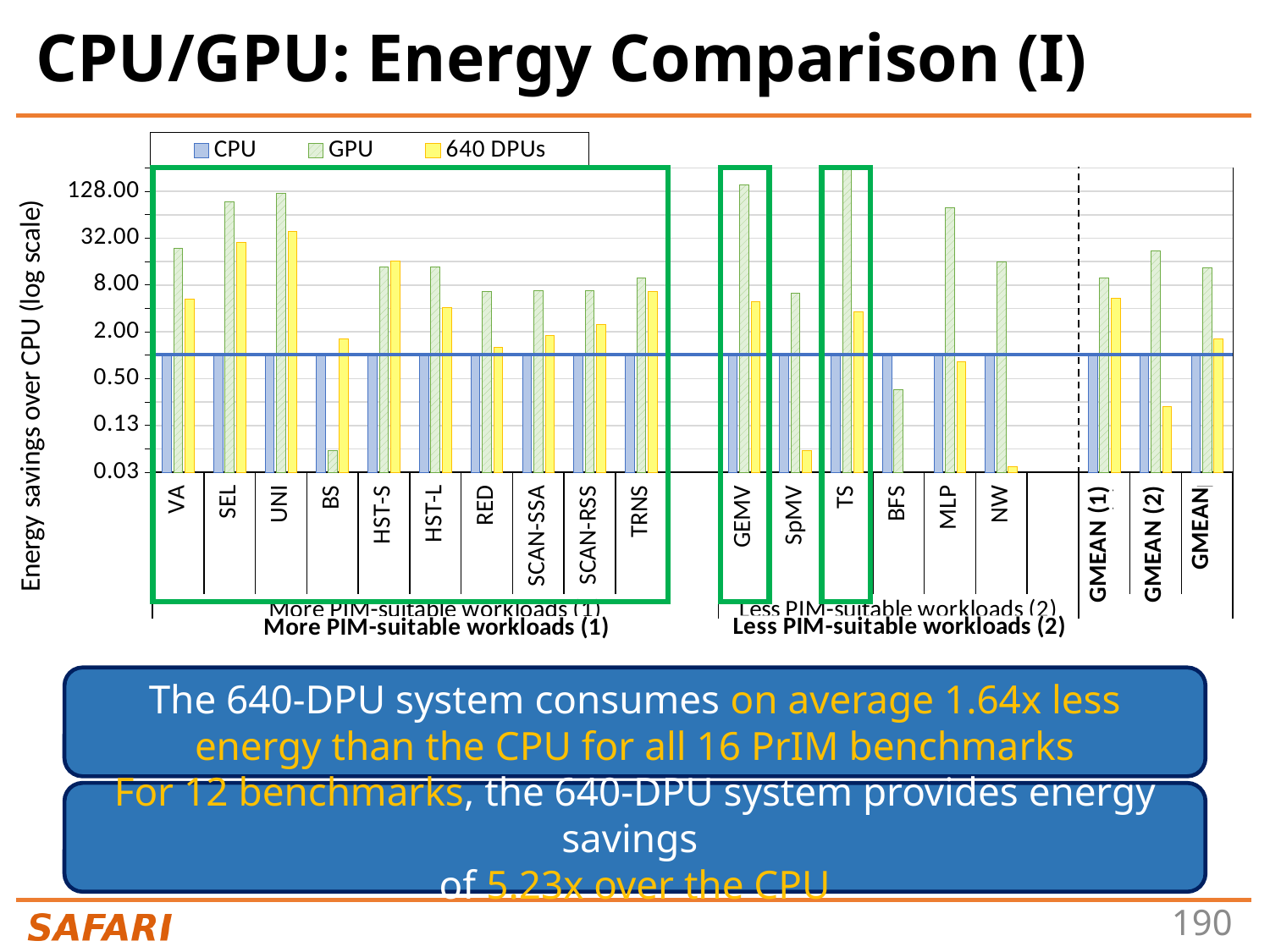
Is the GPU value for GEMV greater or less than 128.00? greater Which benchmark has the highest GPU bar? TS Is the 640 DPUs value for GMEAN (2) greater or less than 0.50? less Is the GPU value for BS greater or less than 0.13? less How many series does the chart legend list? 3 How many benchmark workloads (excluding the GMEAN categories) are shown on the x axis? 16 What kind of chart is shown on the slide? bar chart What is the label of the vertical axis of the chart? Energy savings over CPU (log scale) For BS, which is larger: the GPU value or the 640 DPUs value? 640 DPUs What are the three series named in the chart legend? CPU, GPU, 640 DPUs